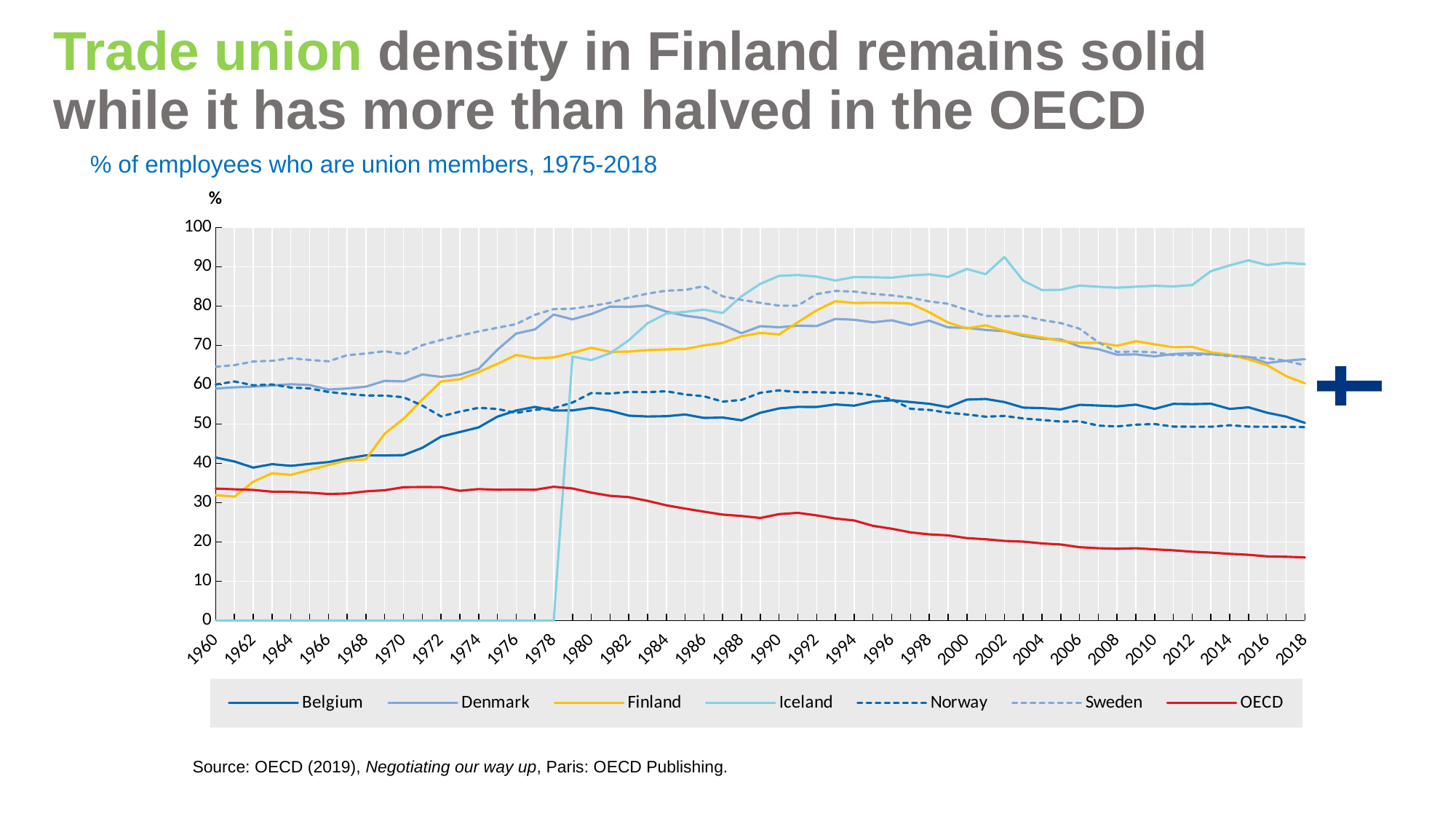
Which series has the highest value in 2018? Iceland Which is larger in 1986, the value for Sweden or the value for Denmark? Sweden Does the OECD line rise or fall from 1960 to 2018? Fall Is the value for Sweden in 1986 greater or less than 80? greater Is the value for Denmark in 2018 greater or less than 60? greater Is the value for Iceland in 2018 greater or less than 80? greater Which is larger in 2018, the value for Finland or the value for Belgium? Finland What kind of chart is shown on the slide? Line chart Which two series are drawn with dashed lines in the legend? Norway and Sweden Which series has the lowest value in 2018? OECD How many series does the legend list? 7